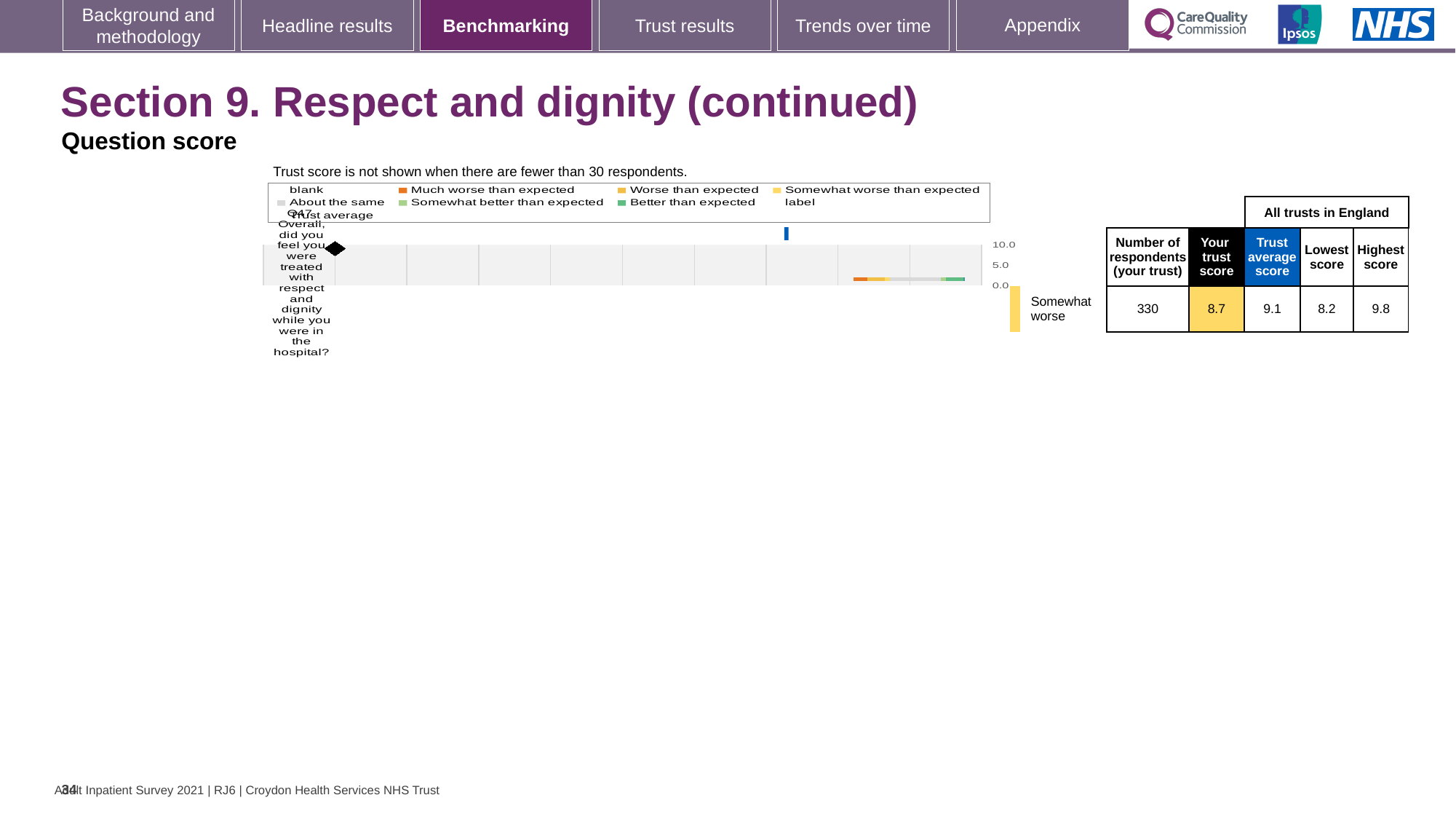
How many questions are plotted on the chart? 1 Is your trust score for Q47 greater or less than 5.0 on the chart's axis? greater How many respondents from your trust answered Q47? 330 What is the highest score among all trusts in England for Q47? 9.8 What kind of chart is shown on the slide? bar chart What is the 'Trust average score' for all trusts in England shown for Q47? 9.1 What benchmark category label is shown to the right of the chart for Q47? Somewhat worse Which is larger for Q47: your trust score or the trust average score? Trust average score What is the difference between the trust average score and your trust score for Q47? 0.4 What is the difference between the highest score and the lowest score for Q47? 1.6 What is the lowest score among all trusts in England for Q47? 8.2 What is the 'Your trust score' for Q47 shown in the table next to the chart? 8.7